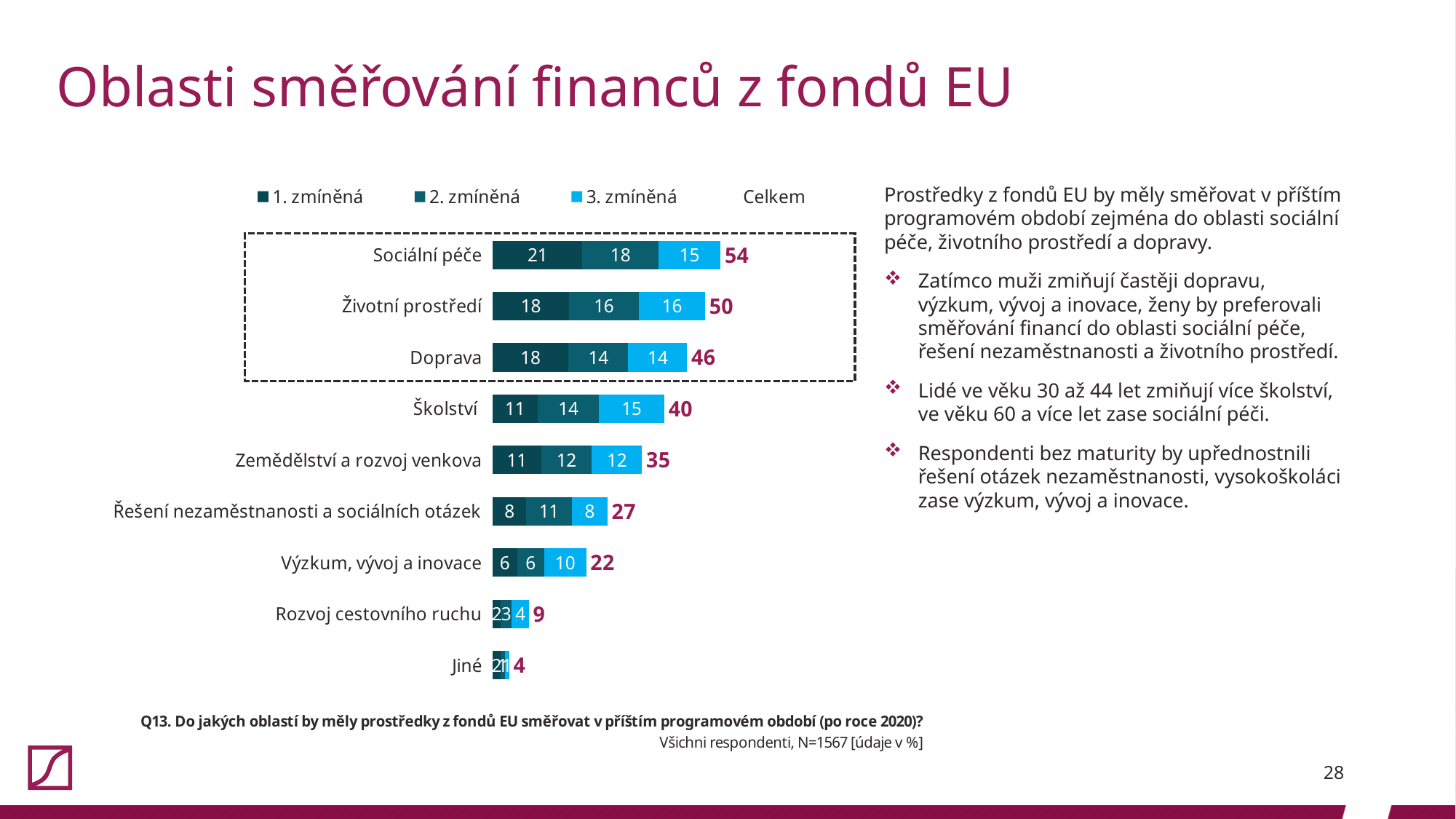
What is the '3. zmíněná' value for Výzkum, vývoj a inovace? 10 What is the first entry listed in the chart legend? 1. zmíněná What kind of chart is shown on the slide? Stacked bar chart Which category has the highest total (Celkem) value? Sociální péče What is the sum of the three segments of the Životní prostředí bar? 50 What is the total (Celkem) value for Sociální péče? 54 What is the difference between the total values for Sociální péče and Doprava? 8 Which category has the lowest total (Celkem) value? Jiné How many categories are shown in the chart? 9 What is the '1. zmíněná' value for Doprava? 18 What is the '2. zmíněná' value for Řešení nezaměstnanosti a sociálních otázek? 11 Which has a larger total value, Školství or Zemědělství a rozvoj venkova? Školství